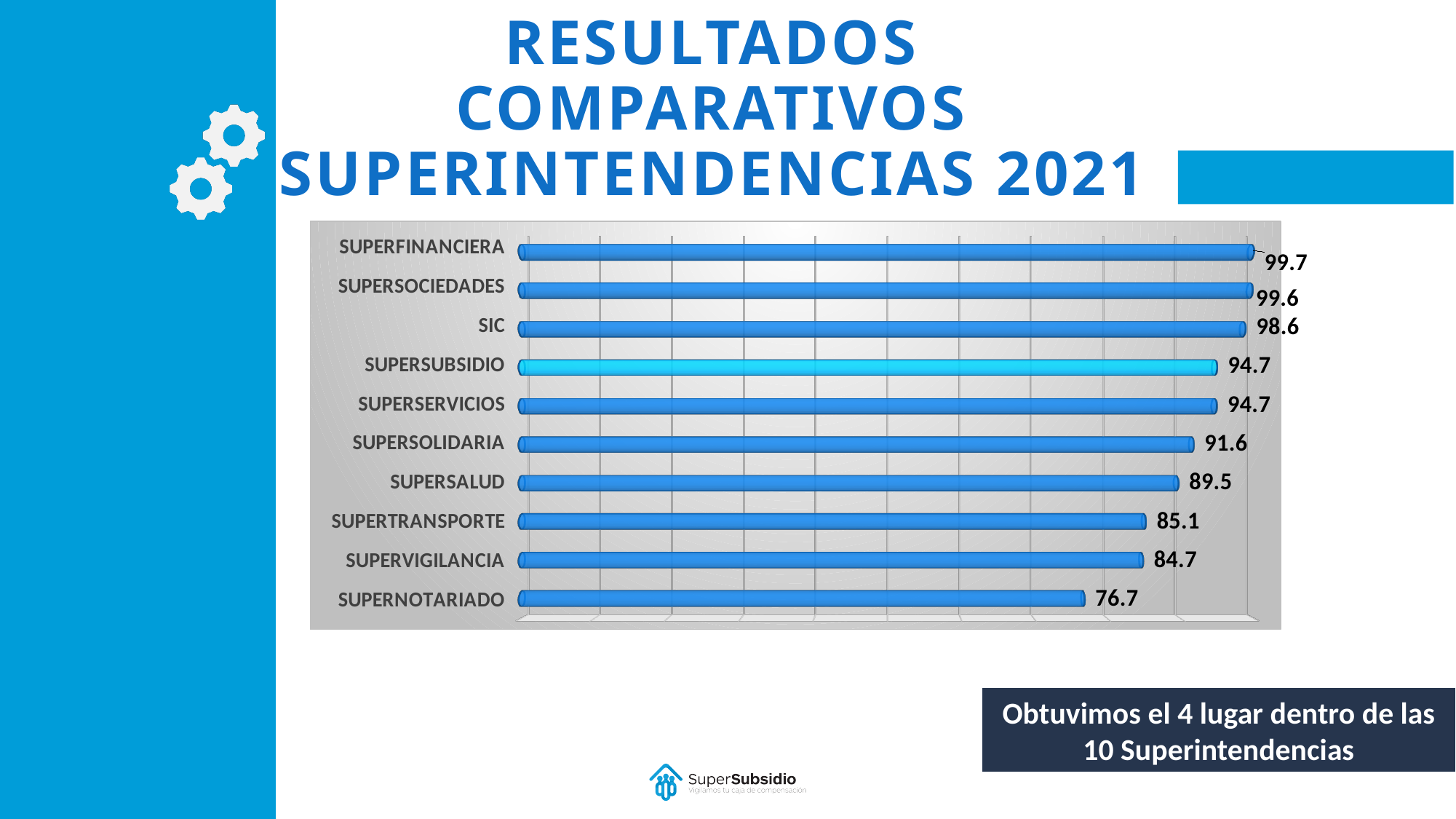
Which category has the highest value? SUPERFINANCIERA What is the difference between the values for SUPERFINANCIERA and SUPERNOTARIADO? 23.0 What is the value for SUPERNOTARIADO? 76.7 What is the value for SUPERSALUD? 89.5 What is the difference between the values for SIC and SUPERSUBSIDIO? 3.9 What is the value for SUPERVIGILANCIA? 84.7 What is the value for SUPERSUBSIDIO? 94.7 What kind of chart is shown on the slide? Bar chart Which is larger, the value for SUPERSOLIDARIA or the value for SUPERTRANSPORTE? SUPERSOLIDARIA How many categories are shown in the chart? 10 Which category has the lowest value? SUPERNOTARIADO Which bar is highlighted in a lighter blue colour than the others? SUPERSUBSIDIO